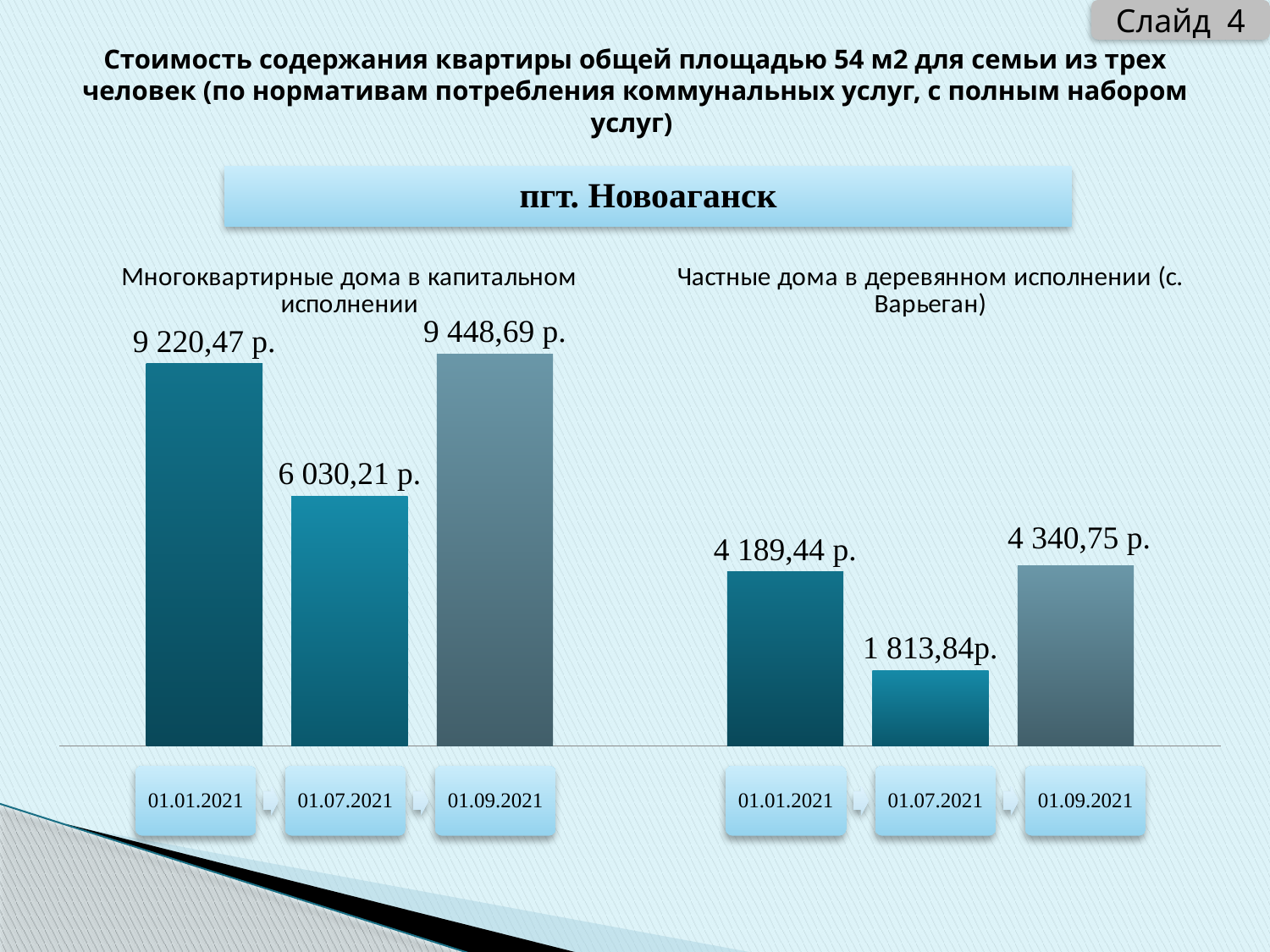
In the left chart (Многоквартирные дома в капитальном исполнении), what is the value for 01.01.2021? 9 220,47 р. In the right chart (Частные дома в деревянном исполнении), what is the value for 01.09.2021? 4 340,75 р. In the right chart (Частные дома в деревянном исполнении), what is the value for 01.07.2021? 1 813,84р. In the left chart (Многоквартирные дома в капитальном исполнении), what is the value for 01.07.2021? 6 030,21 р. In the right chart (Частные дома в деревянном исполнении), which date has the lowest value? 01.07.2021 How many bars does the left chart (Многоквартирные дома в капитальном исполнении) have? 3 What type of chart is used on this slide? Bar chart In the right chart (Частные дома в деревянном исполнении), which is larger: the value for 01.01.2021 or for 01.09.2021? 01.09.2021 In the right chart (Частные дома в деревянном исполнении), what is the difference between the values for 01.01.2021 and 01.07.2021? 2 375,60 р. In the left chart (Многоквартирные дома в капитальном исполнении), what is the difference between the values for 01.09.2021 and 01.01.2021? 228,22 р. In the left chart (Многоквартирные дома в капитальном исполнении), which date has the highest value? 01.09.2021 What is the title of the right chart? Частные дома в деревянном исполнении (с. Варьеган)